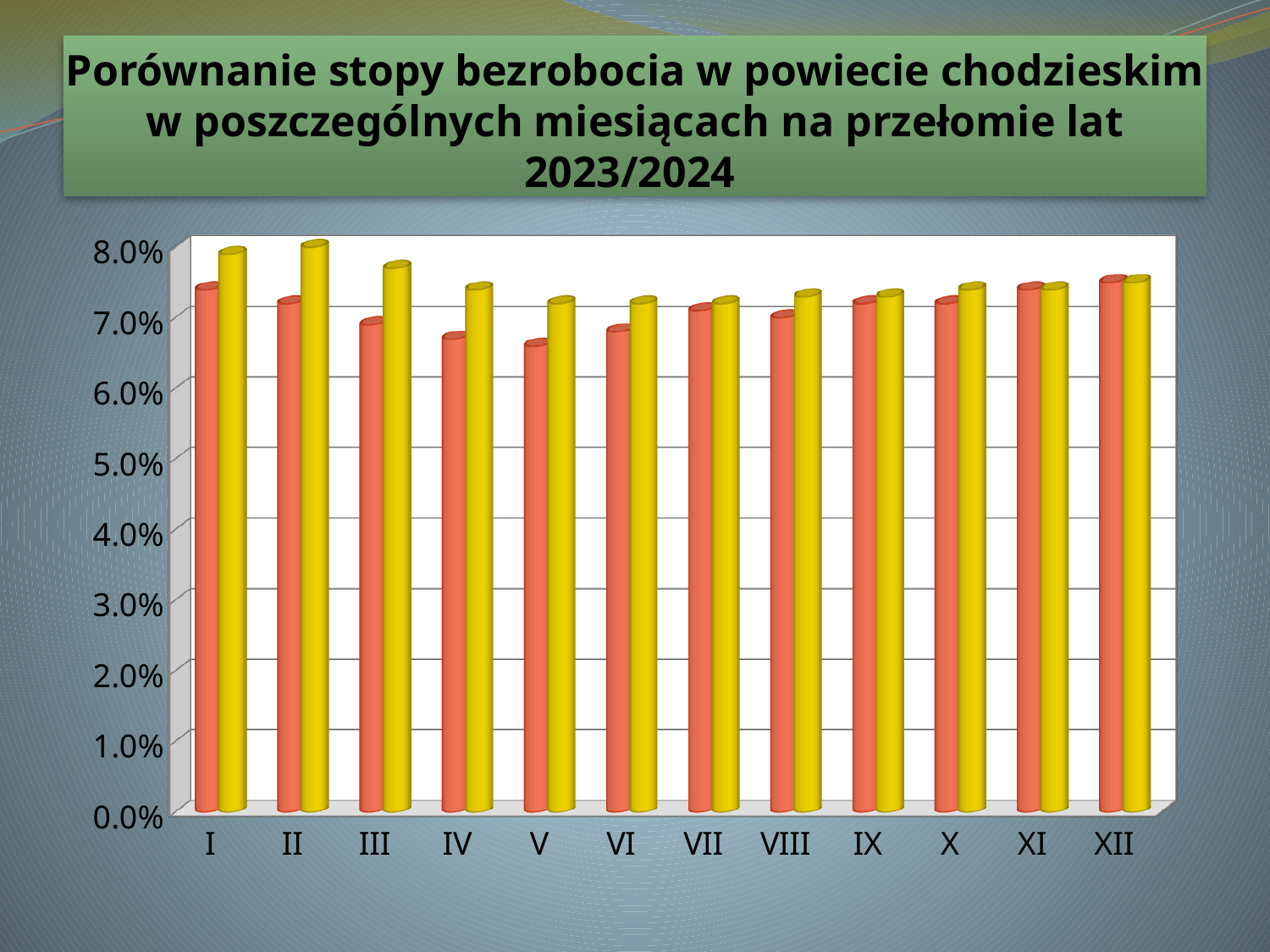
What is the title of the chart? Porównanie stopy bezrobocia w powiecie chodzieskim w poszczególnych miesiącach na przełomie lat 2023/2024 Is the value of the red bar for month IV greater or less than 7.0%? less Is the value of the yellow bar for month II greater or less than 7.0%? greater Is the value of the red bar for month V greater or less than 7.0%? less How many months (categories) are shown on the x axis? 12 In month III, which bar is taller, the red one or the yellow one? yellow How many bars are shown for each month? 2 Do the red bars rise or fall from month I to month V? fall Which month has the tallest yellow bar? II What kind of chart is shown on the slide? bar chart